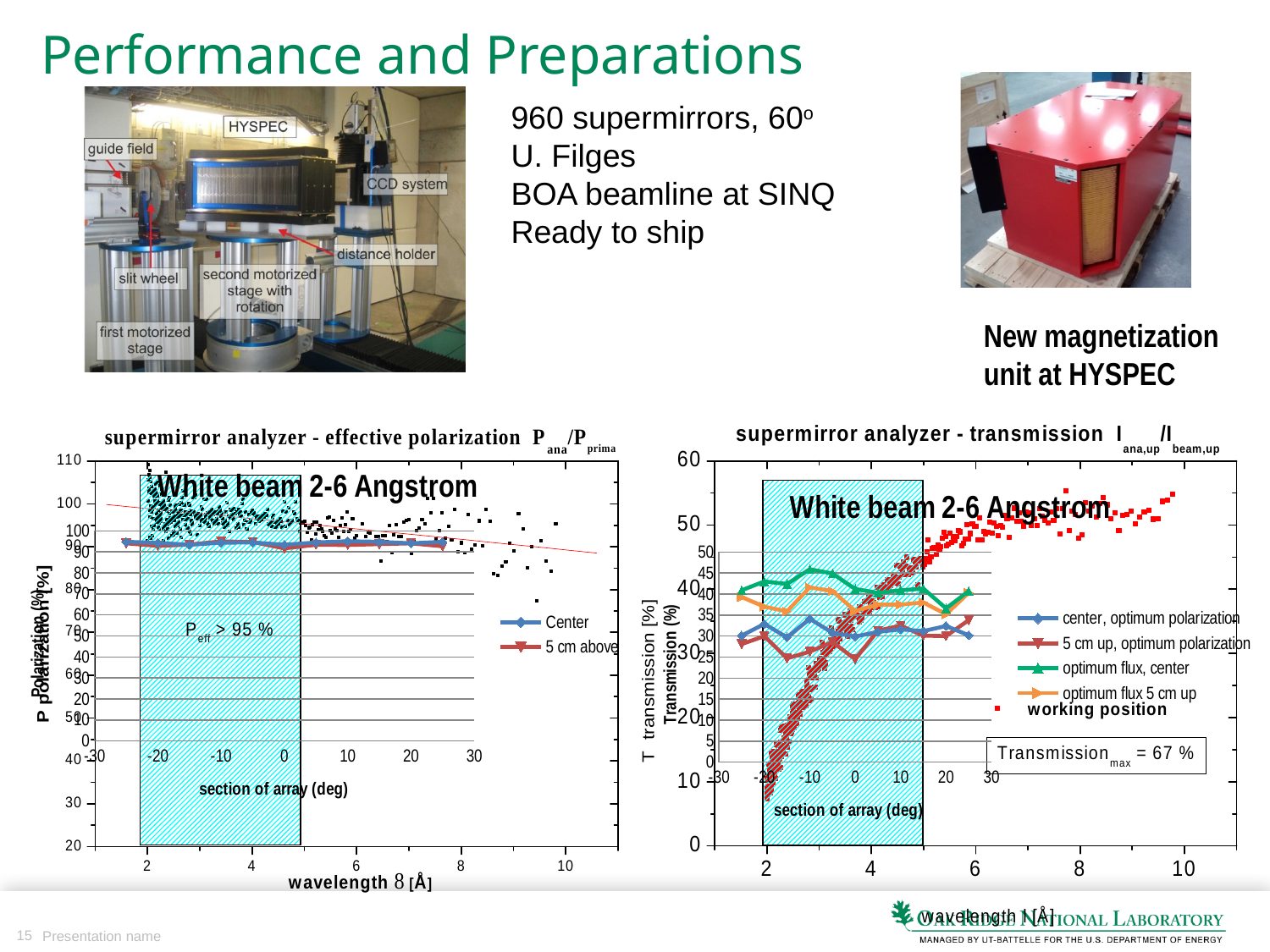
What maximum transmission value is stated in the text box on the right chart? 67 % How many series does the legend of the inset chart inside the left chart (Polarization vs section of array) list? 2 In the right chart (supermirror analyzer - transmission), do the red transmission points rise or fall as wavelength increases? rise What kind of chart is the main plot in the right chart (supermirror analyzer - transmission)? scatter chart In the right chart (supermirror analyzer - transmission), is the transmission at a wavelength of 2 Å greater or less than 20? less In the inset chart inside the left chart (Polarization vs section of array), is the value of the 'Center' series at 0 deg greater or less than 80? greater In the left chart (effective polarization), is the polarization at a wavelength of 3 Å greater or less than 90? greater What is the title of the chart on the left of the slide? supermirror analyzer - effective polarization P_ana/P_prima In the left chart (effective polarization), does the red trend line through the black points rise or fall as wavelength increases? fall In the inset chart inside the right chart (Transmission vs section of array), which series is higher, 'optimum flux, center' or 'center, optimum polarization'? optimum flux, center In the right chart (supermirror analyzer - transmission), what is the label on the x axis? wavelength [Å]